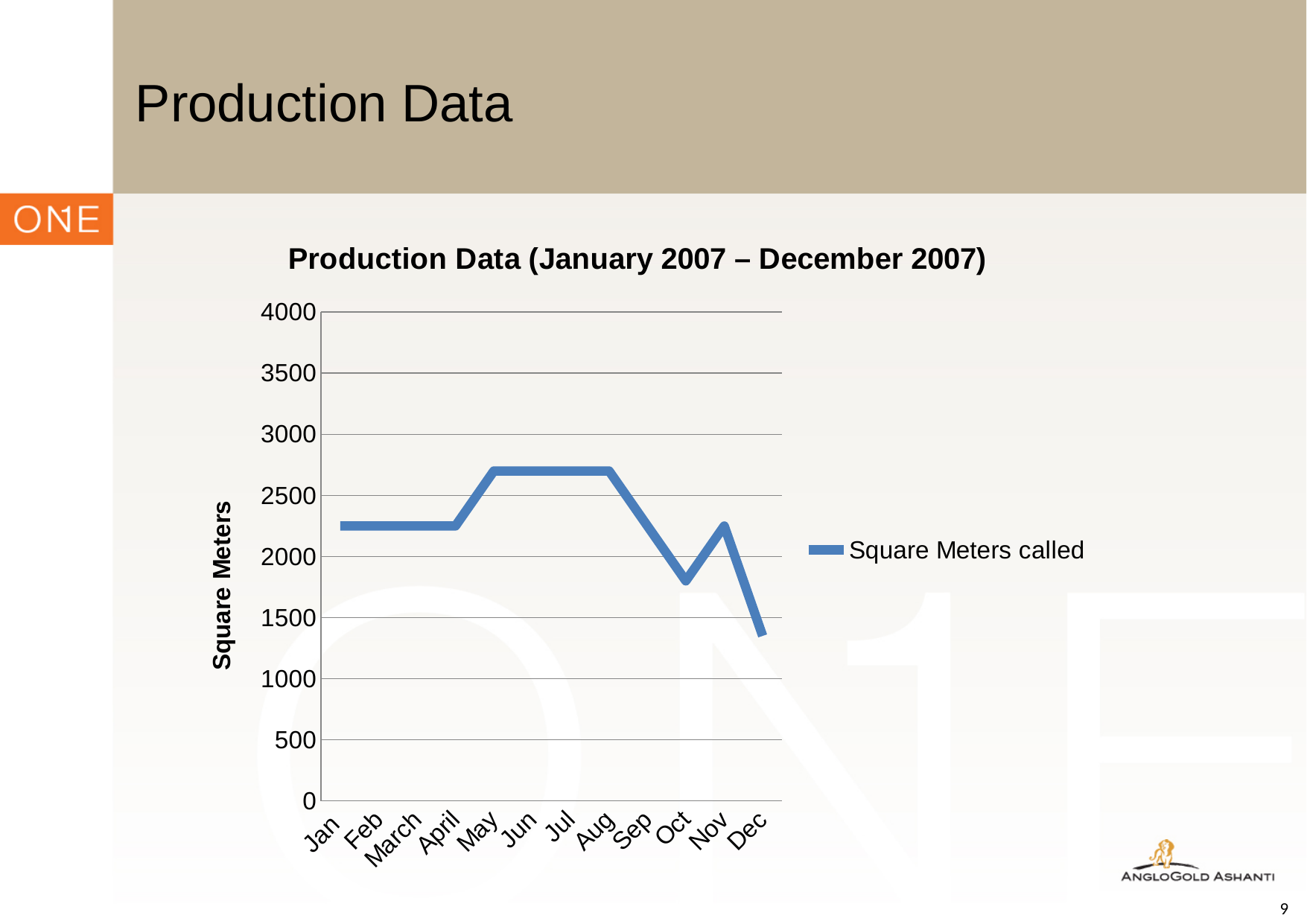
How many series does the chart's legend list? 1 Which month has the larger value, Oct or Dec? Oct Which month has the larger value, Jan or May? May Is the value for Dec greater or less than 1500? less What kind of chart is shown on the slide? line chart Is the value for Oct greater or less than 2000? less Is the value for Jun greater or less than 2500? greater Which month has the lowest value for Square Meters called? Dec What is the label on the chart's vertical axis? Square Meters Do the values rise or fall overall from Aug to Dec? fall How many months are plotted on the x axis of the chart? 12